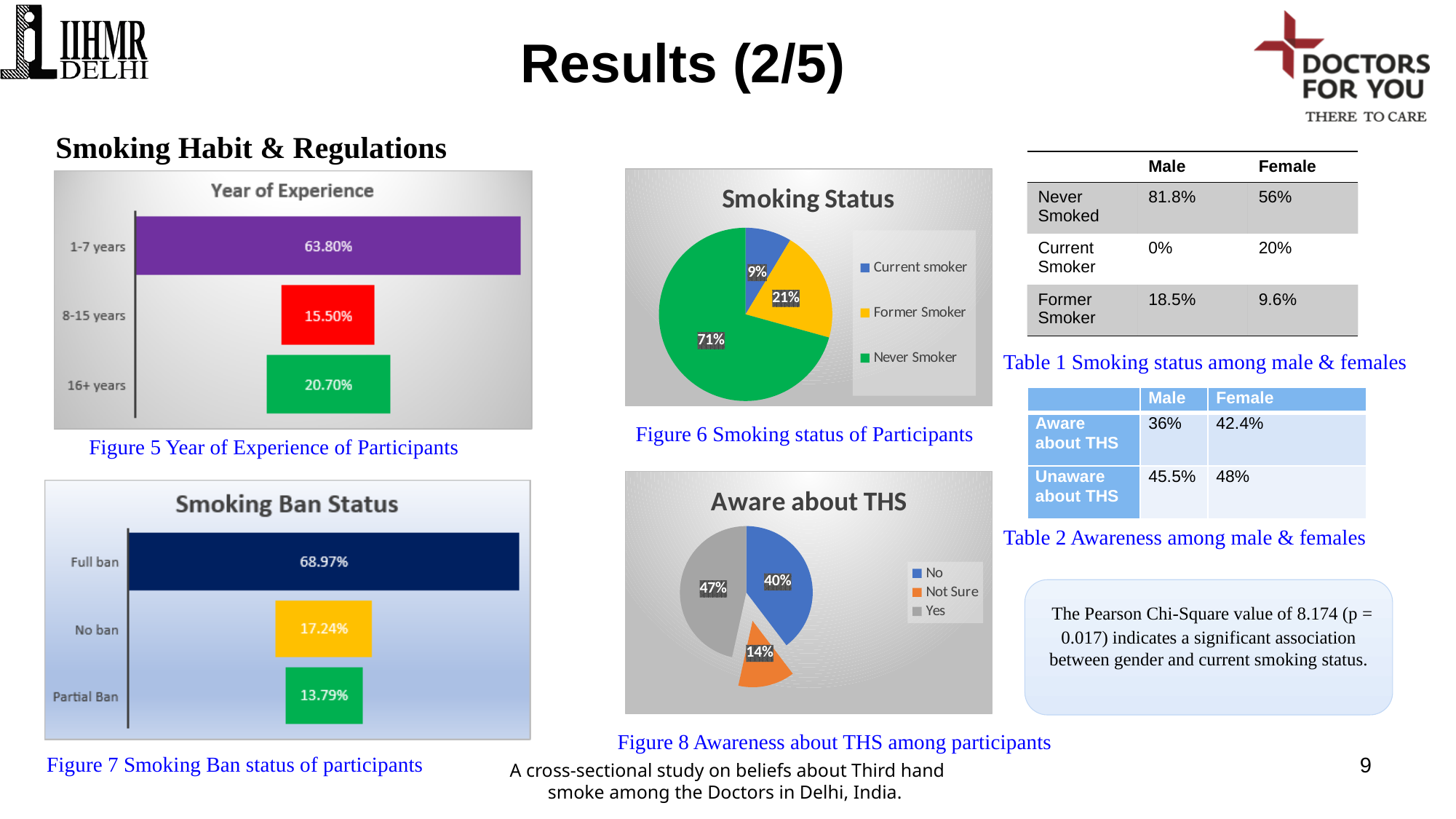
In the 'Smoking Ban Status' chart, what is the difference between Full ban and No ban? 51.73% In the 'Smoking Status' pie chart, what share do Never Smokers have? 71% In the 'Smoking Status' pie chart, which category has the smallest slice? Current smoker In the 'Year of Experience' chart, which category has the lowest value? 8-15 years In the 'Year of Experience' chart, what is the difference between the values for 16+ years and 8-15 years? 5.20% In the 'Smoking Ban Status' chart, what is the value for Full ban? 68.97% In the 'Year of Experience' chart, what is the value for 1-7 years? 63.80% What kind of chart is the 'Smoking Ban Status' chart? Bar chart How many slices does the 'Smoking Status' pie chart have? 3 In the 'Smoking Ban Status' chart, which is larger: No ban or Partial Ban? No ban In the 'Aware about THS' pie chart, what share is labelled Not Sure? 14% How many series does the legend of the 'Aware about THS' pie chart list? 3